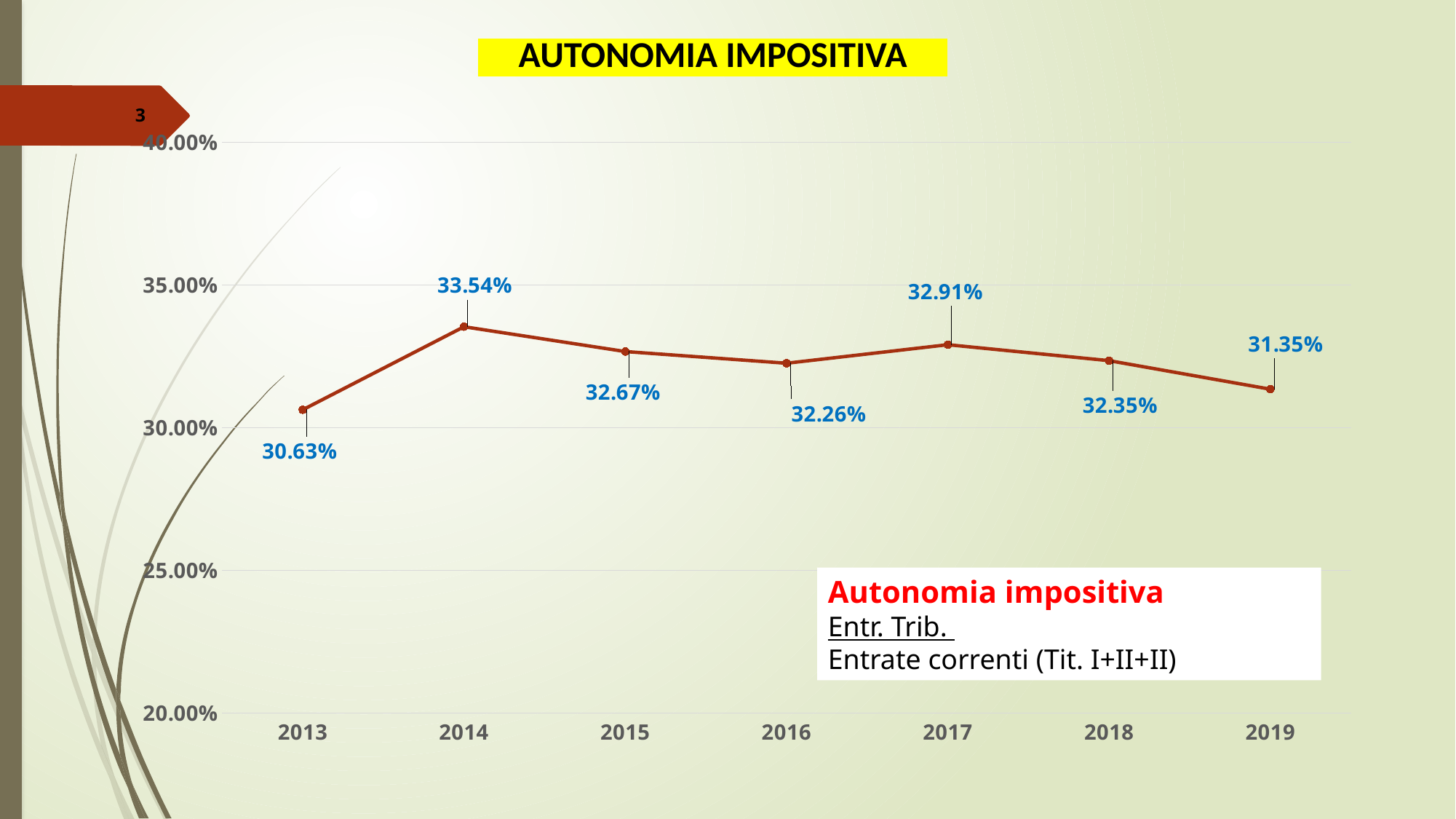
What is the value for 2014? 33.54% Which is larger, the value for 2015 or the value for 2016? 2015 What is the difference between the values for 2014 and 2013? 2.91% What is the value for 2016? 32.26% What kind of chart is shown on the slide? line chart Do the values rise or fall from 2017 to 2019? fall Which year has the highest value? 2014 How many years are plotted on the chart? 7 What is the difference between the values for 2017 and 2018? 0.56% Is the value for 2013 greater or less than 35.00%? less What is the value for 2019? 31.35% Which year has the lowest value? 2013